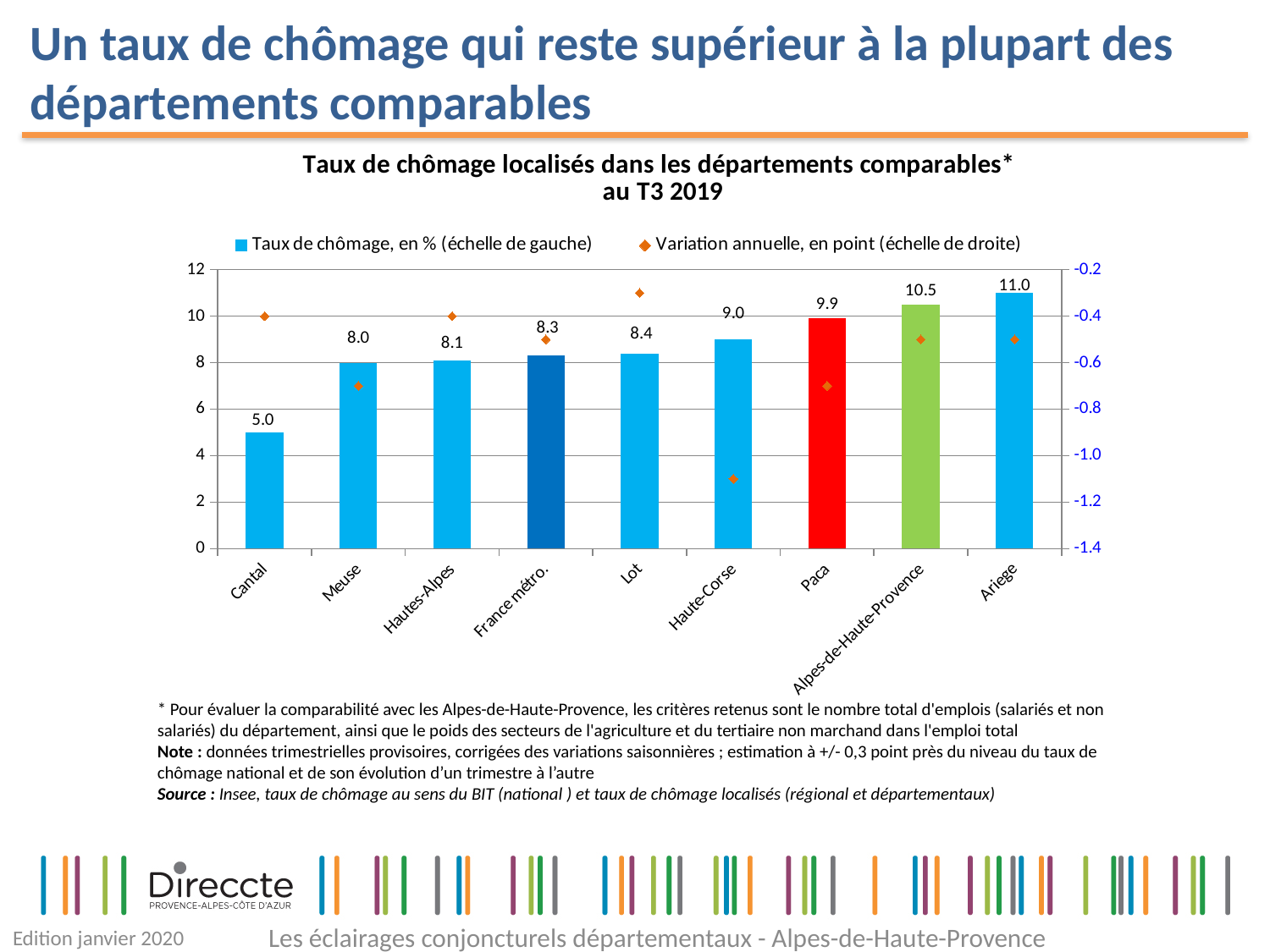
Which department has the highest unemployment rate on the chart? Ariege Is the annual variation (variation annuelle) for Haute-Corse greater or less than -0.6? less What is the title of the chart? Taux de chômage localisés dans les départements comparables* au T3 2019 Which has the higher unemployment rate, Haute-Corse or Lot? Haute-Corse How many series does the legend list? 2 What is the difference between the unemployment rate of Ariège and that of Cantal? 6.0 What is the unemployment rate (taux de chômage) shown for Alpes-de-Haute-Provence? 10.5 What is the difference between the unemployment rate of Alpes-de-Haute-Provence and that of Paca? 0.6 Which department has the lowest unemployment rate on the chart? Cantal What is the unemployment rate shown for Cantal? 5.0 What is the unemployment rate shown for France métro.? 8.3 How many departments or areas are shown on the x axis? 9